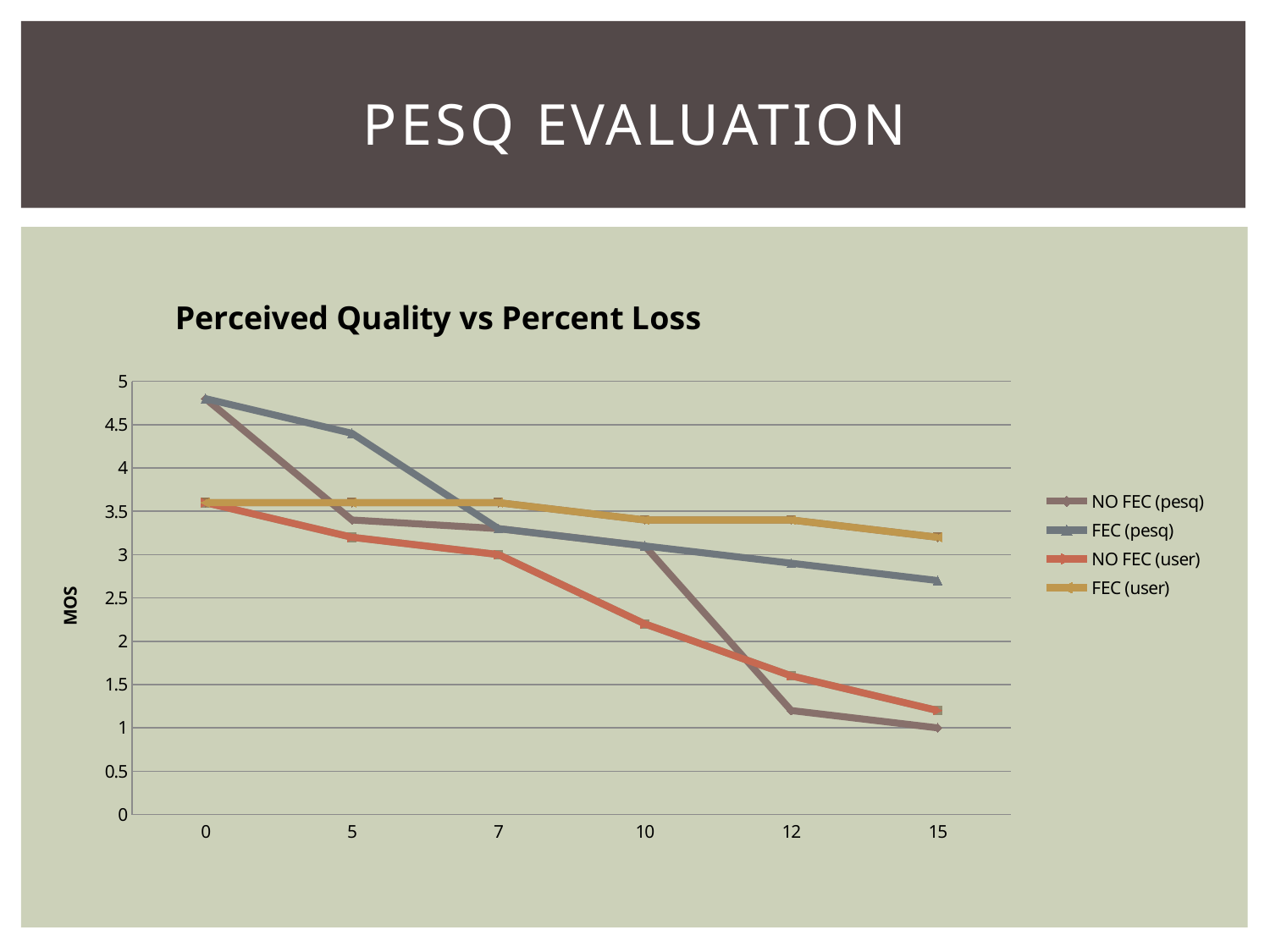
What is the title of the chart? Perceived Quality vs Percent Loss What is the MOS value for NO FEC (user) at 7 percent loss? 3 At 12 percent loss, which is larger: FEC (pesq) or NO FEC (user)? FEC (pesq) What is the label on the y axis? MOS What is the MOS value for NO FEC (pesq) at 15 percent loss? 1 Which series has the lowest MOS at 15 percent loss? NO FEC (pesq) What kind of chart is shown on the slide? line chart How many percent-loss points are plotted along the x axis? 6 Do the MOS values for NO FEC (user) rise or fall as percent loss increases? fall Which series has the highest MOS at 15 percent loss? FEC (user) Is the value for FEC (pesq) at 15 percent loss greater or less than 3? less How many series does the legend list? 4